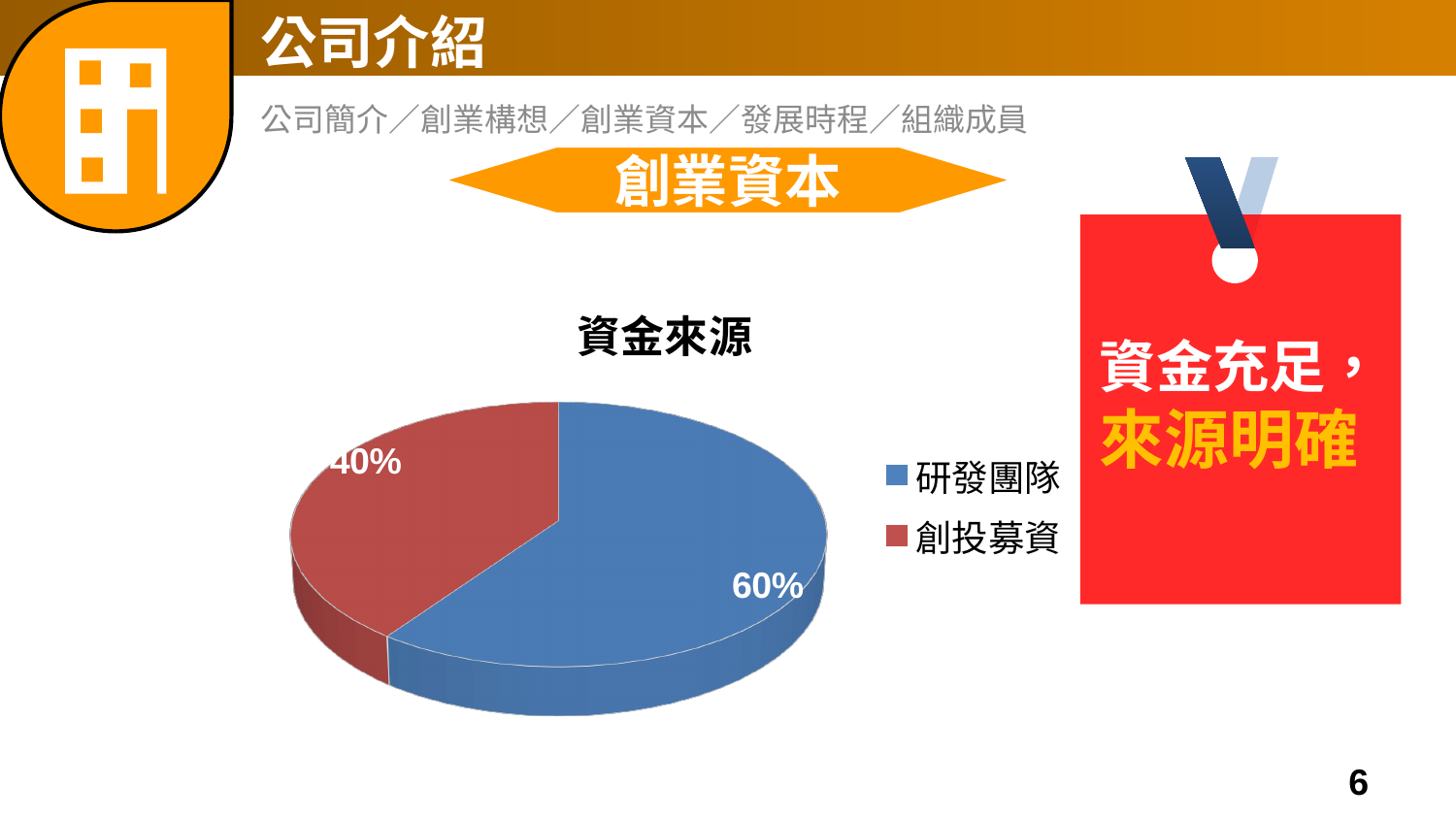
Which category has the largest share of the pie? 研發團隊 How many slices does the pie chart have? 2 Which is larger, the 研發團隊 slice or the 創投募資 slice? 研發團隊 What colour is the 創投募資 slice? Red Is the share for 研發團隊 greater or less than 50%? greater What share of the pie does 創投募資 account for? 40% Which category has the smallest share of the pie? 創投募資 What kind of chart is shown on the slide? Pie chart What is the title of the chart? 資金來源 What share of the pie does 研發團隊 account for? 60% How many entries does the legend list? 2 What is the difference in percentage points between the 研發團隊 and 創投募資 slices? 20%